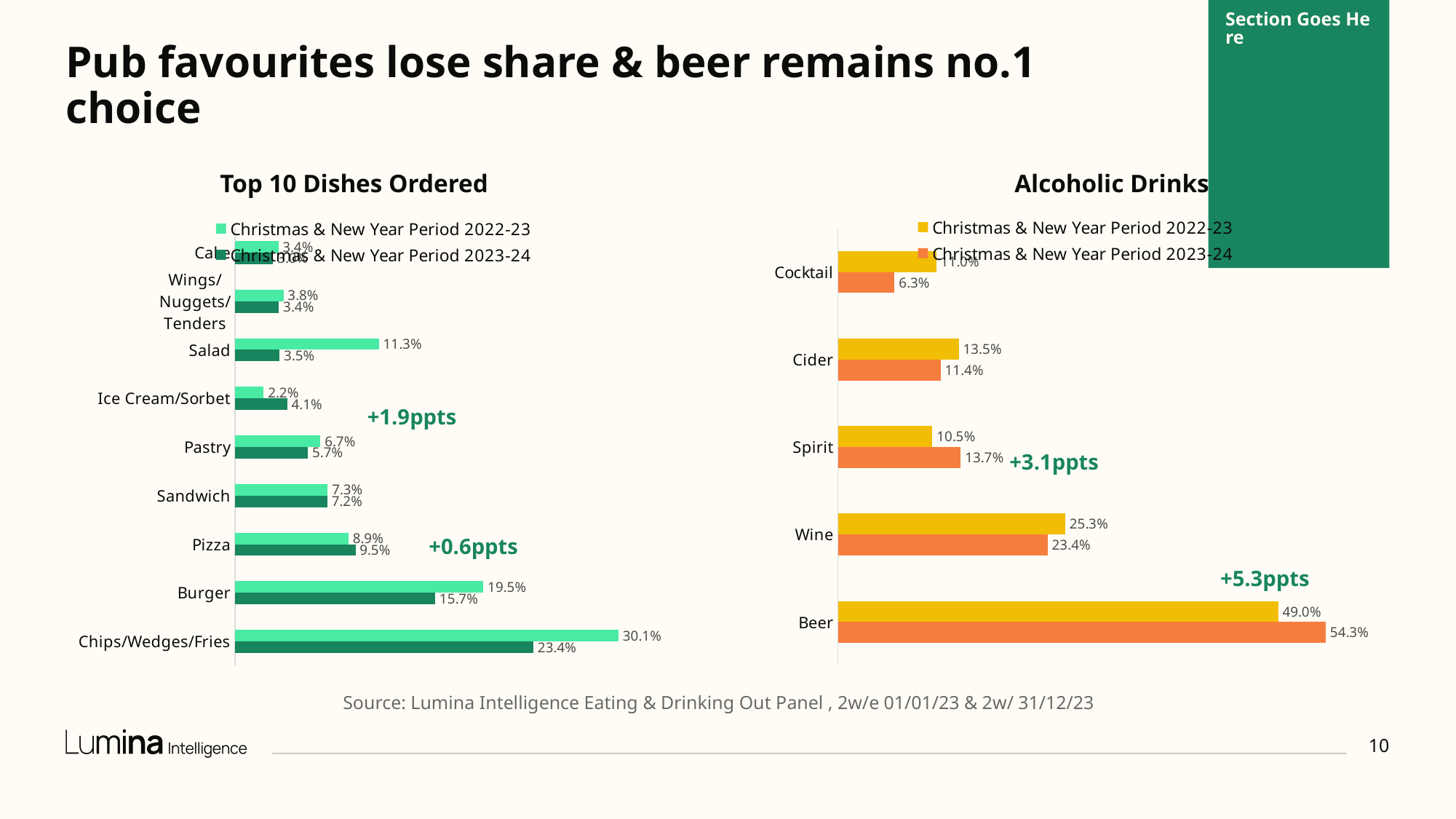
In the Top 10 Dishes Ordered chart, which dish has the highest value for the Christmas & New Year Period 2023-24? Chips/Wedges/Fries In the Alcoholic Drinks chart, what is the value for Beer in the Christmas & New Year Period 2023-24? 54.3% In the Top 10 Dishes Ordered chart, what is the difference between the Burger values for 2022-23 and 2023-24? 3.8 percentage points How many drink categories are shown in the Alcoholic Drinks chart? 5 How many series does the legend of the Alcoholic Drinks chart list? 2 In the Top 10 Dishes Ordered chart, which is larger for the Christmas & New Year Period 2023-24: Pizza or Sandwich? Pizza In the Alcoholic Drinks chart, what is the value for Spirit in the Christmas & New Year Period 2023-24? 13.7% In the Top 10 Dishes Ordered chart, what is the value for Chips/Wedges/Fries in the Christmas & New Year Period 2023-24? 23.4% In the Alcoholic Drinks chart, by how much did the Beer value increase from 2022-23 to 2023-24? 5.3 percentage points In the Top 10 Dishes Ordered chart, what is the value for Salad in the Christmas & New Year Period 2022-23? 11.3% In the Alcoholic Drinks chart, which drink has the highest value for the Christmas & New Year Period 2022-23? Beer In the Alcoholic Drinks chart, which drink has the lowest value for the Christmas & New Year Period 2023-24? Cocktail